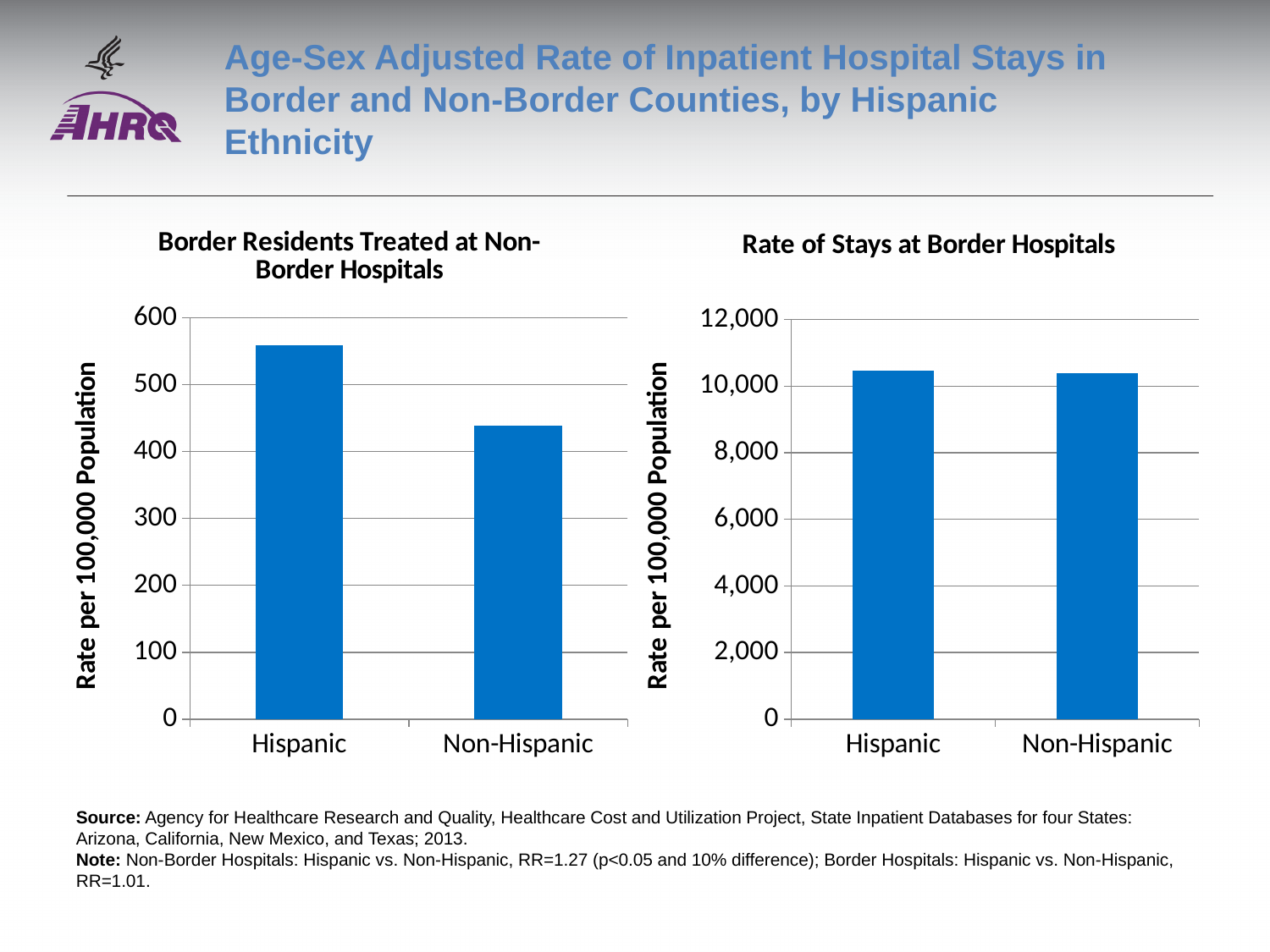
In the chart titled "Border Residents Treated at Non-Border Hospitals", is the value for Non-Hispanic greater or less than 400? greater In the chart titled "Border Residents Treated at Non-Border Hospitals", what kind of chart is shown? Bar chart In the chart titled "Border Residents Treated at Non-Border Hospitals", which category has the highest rate? Hispanic In the chart titled "Rate of Stays at Border Hospitals", is the value for Non-Hispanic greater or less than 12,000? less What is the title of the chart on the left side of the slide? Border Residents Treated at Non-Border Hospitals In the chart titled "Border Residents Treated at Non-Border Hospitals", which is larger, the value for Hispanic or for Non-Hispanic? Hispanic In the chart titled "Rate of Stays at Border Hospitals", how many categories are plotted? 2 In the chart titled "Border Residents Treated at Non-Border Hospitals", is the value for Non-Hispanic greater or less than 500? less In the chart titled "Border Residents Treated at Non-Border Hospitals", which category has the lowest rate? Non-Hispanic What is the y-axis label of the chart titled "Rate of Stays at Border Hospitals"? Rate per 100,000 Population